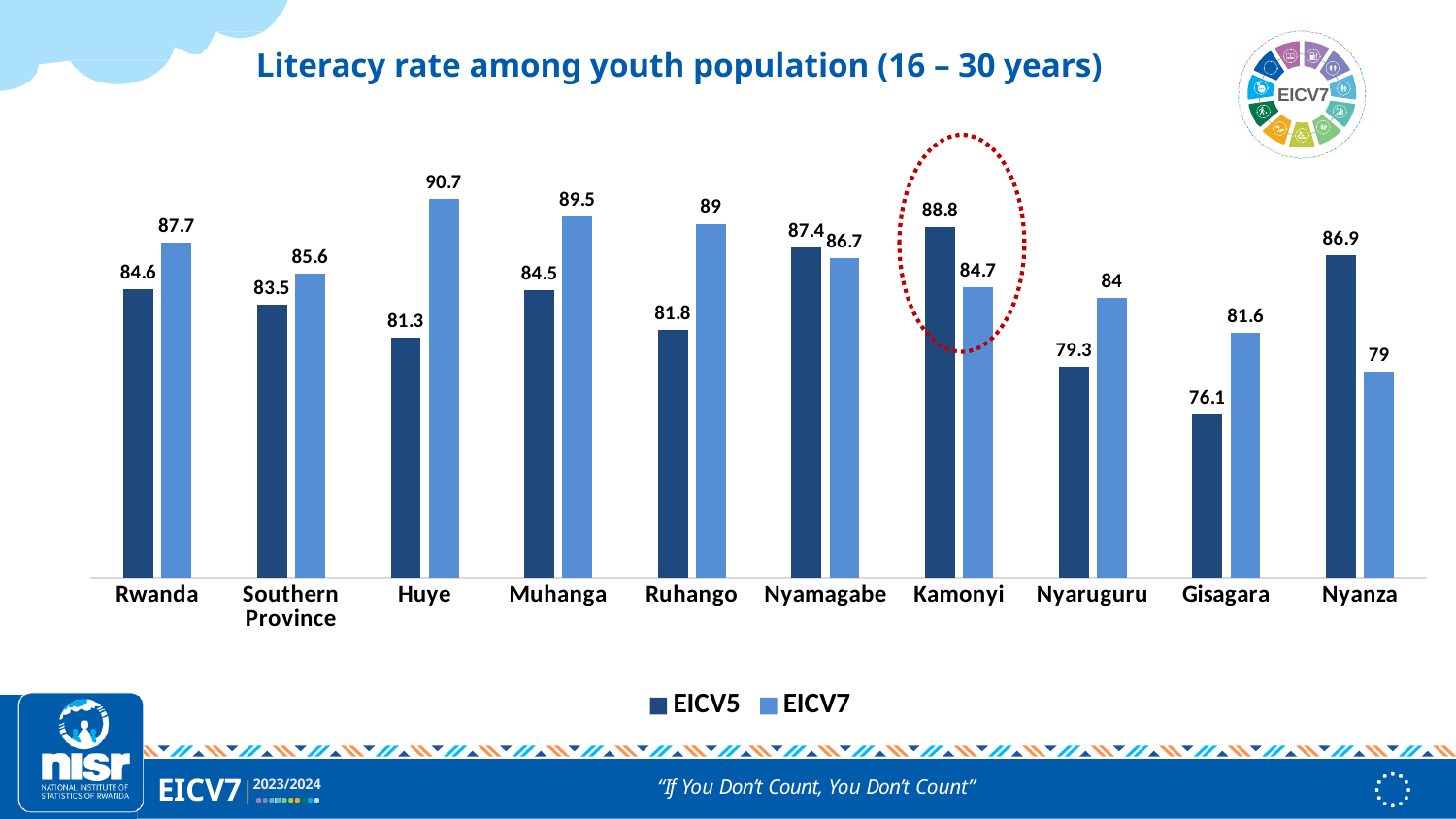
For Kamonyi, which is larger, the EICV5 value or the EICV7 value? EICV5 How many categories are shown on the x axis? 10 For Nyanza, which is larger, the EICV5 value or the EICV7 value? EICV5 What is the EICV5 literacy rate for Gisagara? 76.1 Which category has the highest EICV7 value? Huye What is the EICV7 value for Southern Province? 85.6 Which category has the lowest EICV5 value? Gisagara What kind of chart is shown on the slide? Bar chart What is the EICV7 literacy rate for Huye? 90.7 How many series does the legend list? 2 What is the difference between the EICV7 and EICV5 values for Huye? 9.4 Which category is highlighted with a red dotted circle? Kamonyi